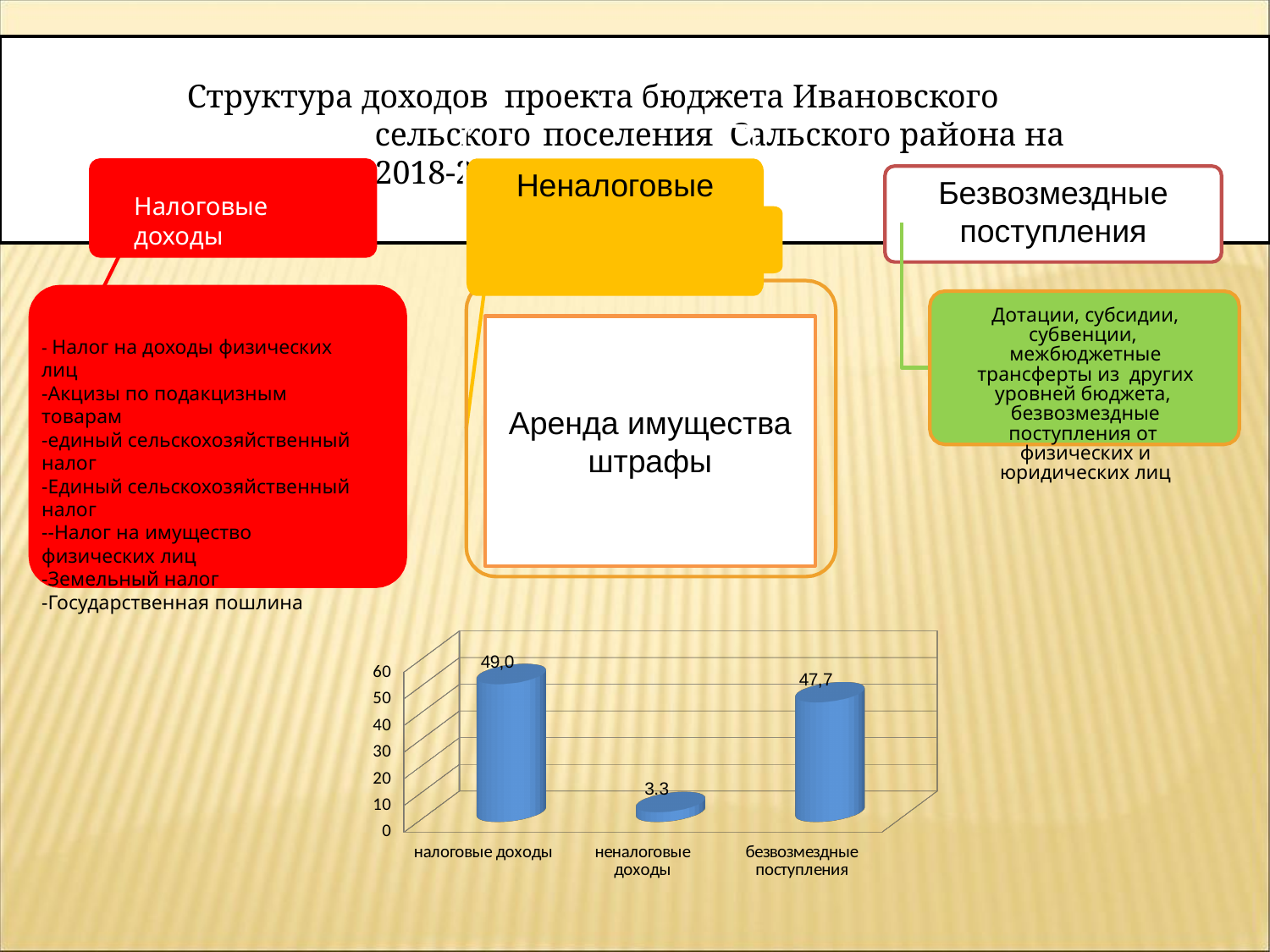
What is the difference between the values for безвозмездные поступления and неналоговые доходы? 44,4 What is the value for безвозмездные поступления? 47,7 Which category has the lowest value? неналоговые доходы Is the value for неналоговые доходы greater or less than 10? less What is the value for налоговые доходы? 49,0 What is the value for неналоговые доходы? 3,3 What kind of chart is shown on the slide? bar chart What is the difference between the values for налоговые доходы and безвозмездные поступления? 1,3 Which category has the highest value? налоговые доходы How many categories are shown on the chart? 3 Is the value for безвозмездные поступления greater or less than 40? greater Which is larger, the value for налоговые доходы or the value for неналоговые доходы? налоговые доходы